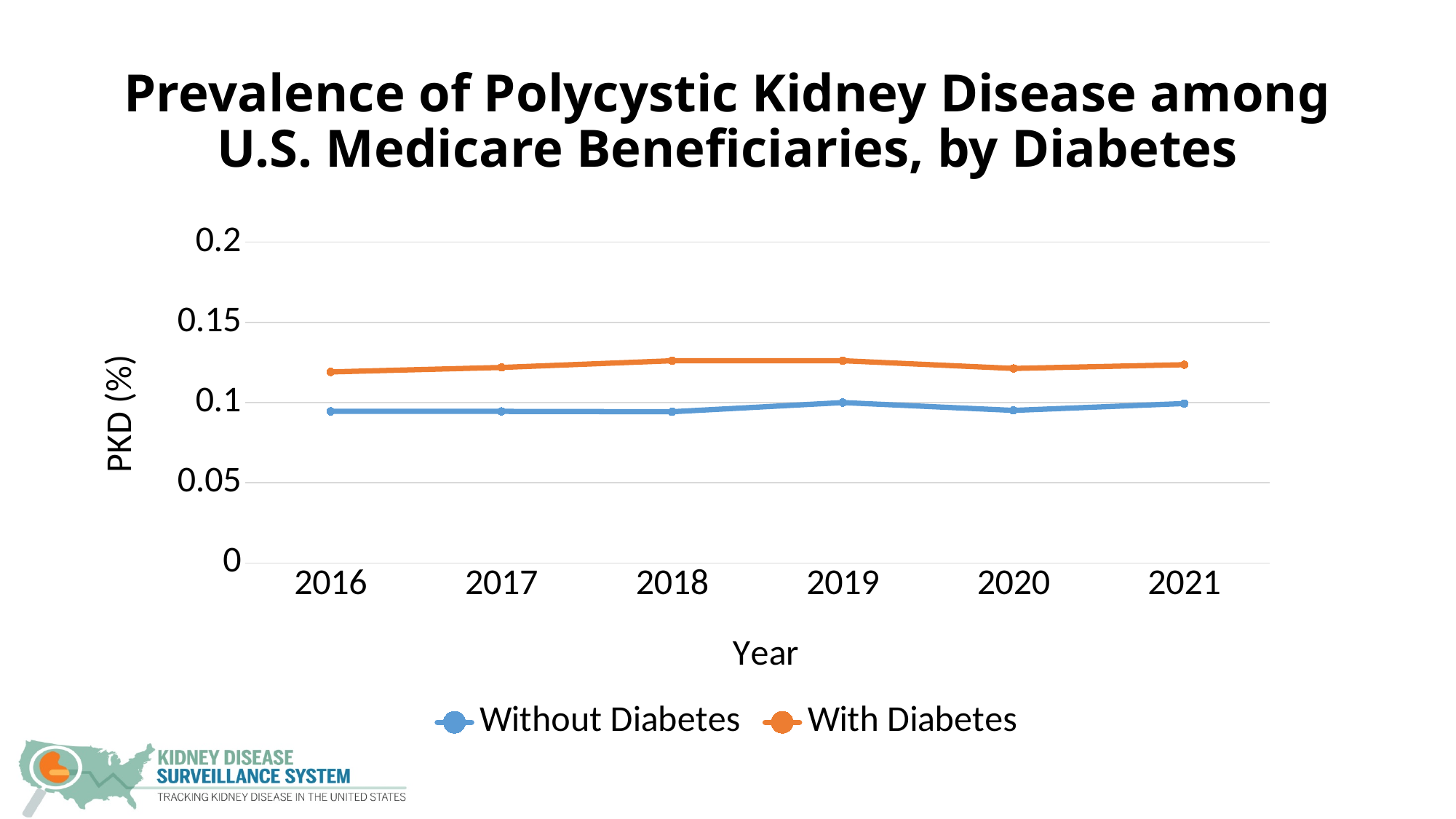
How many series does the legend list? 2 Is the value for With Diabetes in 2018 greater or less than 0.1? greater Is the value for Without Diabetes in 2017 greater or less than 0.15? less What kind of chart is shown on the slide? line chart Is the value for With Diabetes in 2021 greater or less than 0.15? less Which series has the higher value in 2016, With Diabetes or Without Diabetes? With Diabetes Does the With Diabetes line rise or fall from 2016 to 2018? rise What is the label on the y axis? PKD (%) Which series has the higher value in 2019, With Diabetes or Without Diabetes? With Diabetes Which colour is used for the With Diabetes series? orange How many years are plotted along the x axis? 6